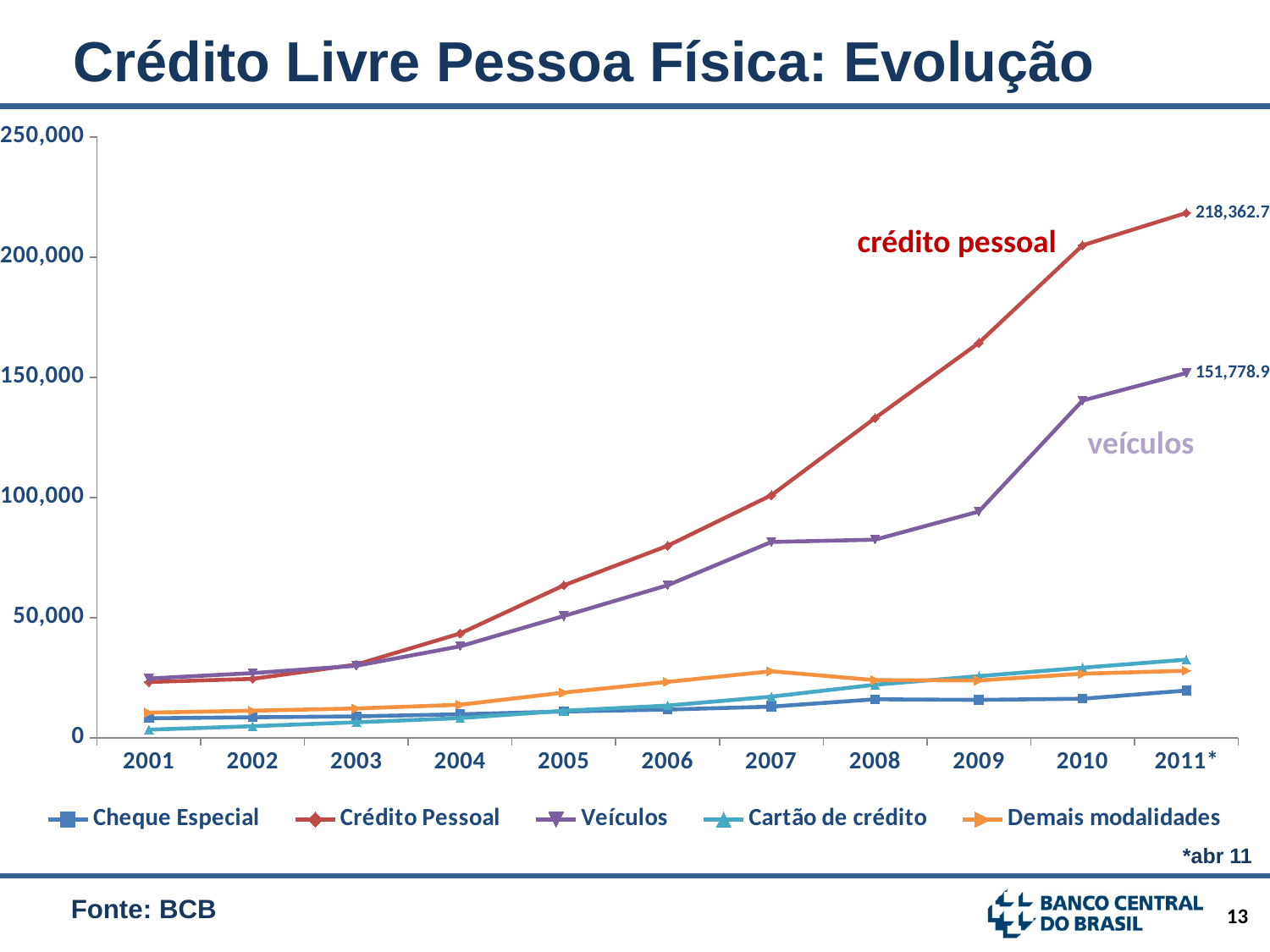
Does the Crédito Pessoal series rise or fall from 2001 to 2011*? Rise How many series does the legend list? 5 What kind of chart is shown on the slide? Line chart What is the difference between Crédito Pessoal and Veículos in 2011*? 66,583.8 What is the value of Veículos in 2011*? 151,778.9 Which series has the highest value in 2011*? Crédito Pessoal Is the value for Crédito Pessoal in 2009 greater or less than 150,000? greater What is the title of the slide? Crédito Livre Pessoa Física: Evolução Is the value for Veículos in 2010 greater or less than 150,000? less What is the value of Crédito Pessoal in 2011*? 218,362.7 Which series has the lowest value in 2011*? Cheque Especial How many years are shown on the x axis? 11